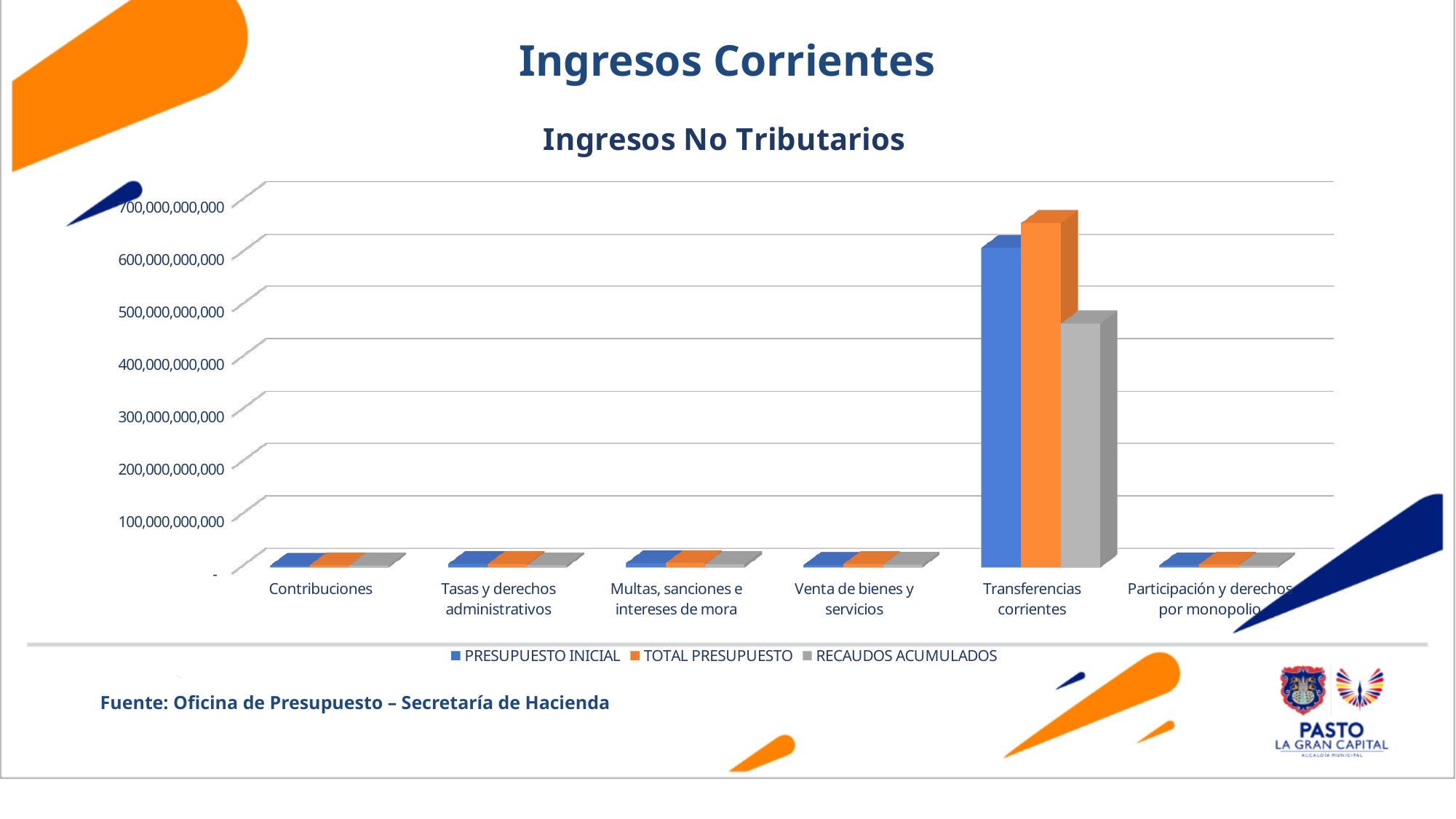
Is the TOTAL PRESUPUESTO value for Contribuciones greater or less than 100,000,000,000? less How many series does the legend list? 3 Is the RECAUDOS ACUMULADOS value for Transferencias corrientes greater or less than 400,000,000,000? greater Is the TOTAL PRESUPUESTO value for Transferencias corrientes greater or less than 600,000,000,000? greater What kind of chart is shown on the slide? Bar chart How many categories are shown on the x axis? 6 Which series is shown in orange in the legend? TOTAL PRESUPUESTO For Transferencias corrientes, which is larger: TOTAL PRESUPUESTO or RECAUDOS ACUMULADOS? TOTAL PRESUPUESTO What is the title of the chart? Ingresos No Tributarios Which category has the highest values across all series? Transferencias corrientes